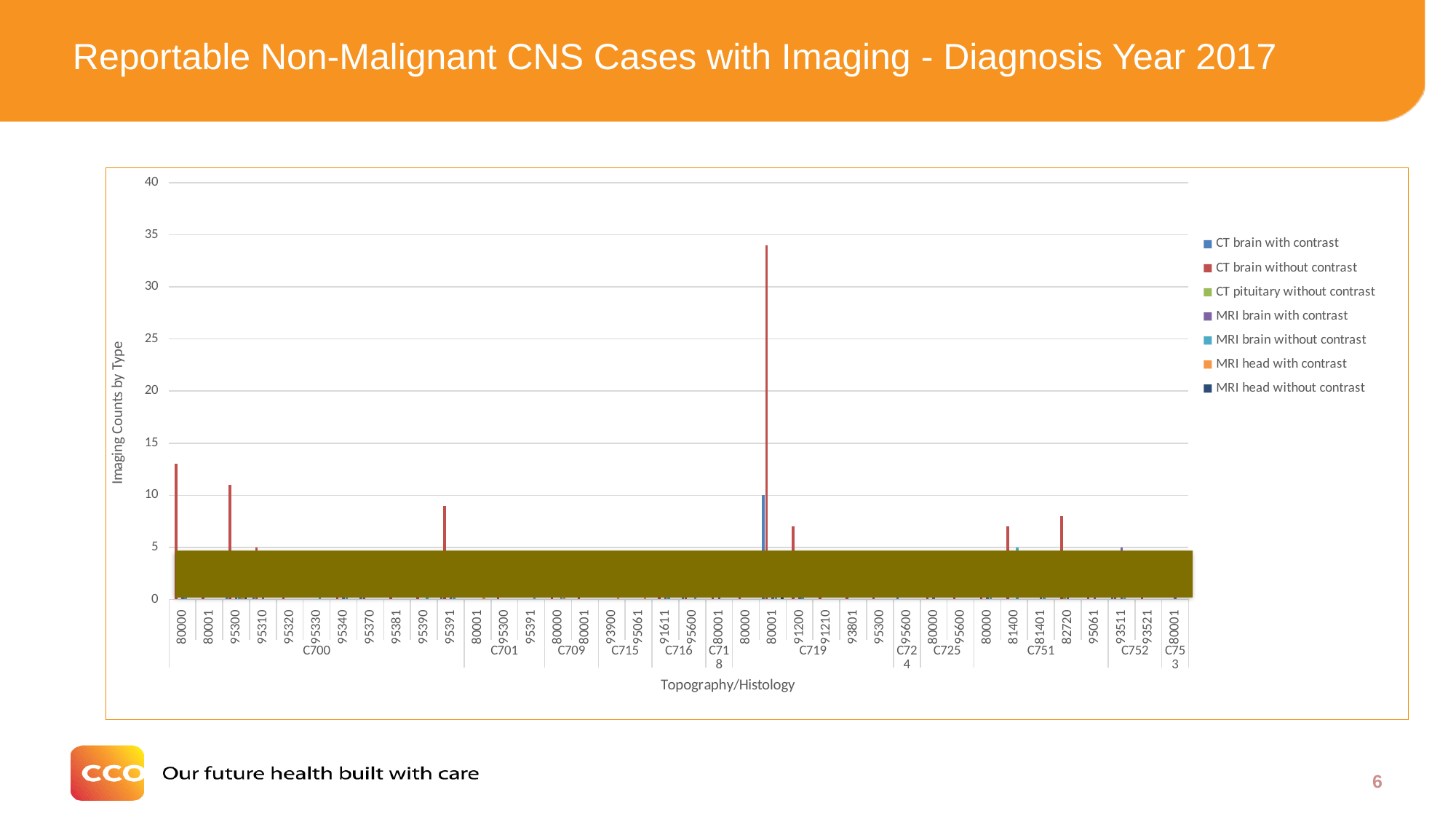
Is the CT brain without contrast value for histology 91200 under C719 greater or less than 10? less What is the label on the horizontal axis of the chart? Topography/Histology Is the CT brain without contrast value for histology 95391 under C700 greater or less than 10? less Which is larger: the CT brain without contrast bar for histology 80001 under C718, or the CT brain without contrast bar for histology 80000 under C700? histology 80000 under C700 How many series does the chart's legend list? 7 Which series has the tallest bar in the chart? CT brain without contrast What kind of chart is shown on the slide? bar chart Under which topography code does the tallest bar in the chart appear? C719 Is the CT brain without contrast value for histology 80000 under C700 greater or less than 10? greater What is the highest value shown on the vertical axis of the chart? 40 What is the label on the vertical axis of the chart? Imaging Counts by Type